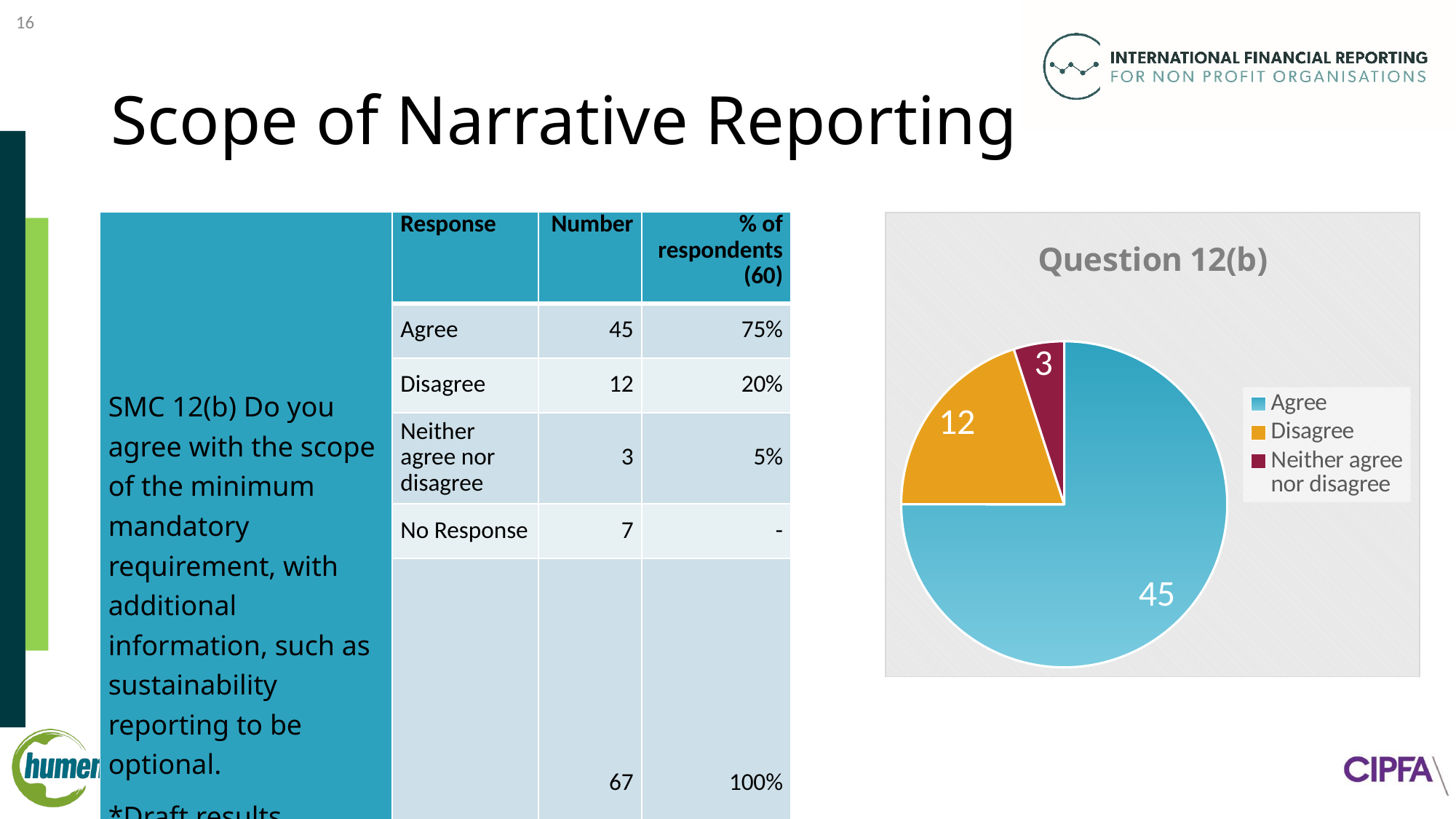
Which category has the smallest slice in the pie chart? Neither agree nor disagree What is the difference between the Agree and Disagree values in the pie chart? 33 In the pie chart, what is the value for Neither agree nor disagree? 3 Which is larger in the pie chart, Disagree or Neither agree nor disagree? Disagree How many entries does the pie chart legend list? 3 In the pie chart, what is the value for Disagree? 12 What kind of chart is shown on the slide? pie chart In the pie chart, what is the value for Agree? 45 What is the title of the pie chart? Question 12(b) Which category has the largest slice in the pie chart? Agree What share of the pie chart does the Agree slice represent? 75% How many slices does the pie chart have? 3